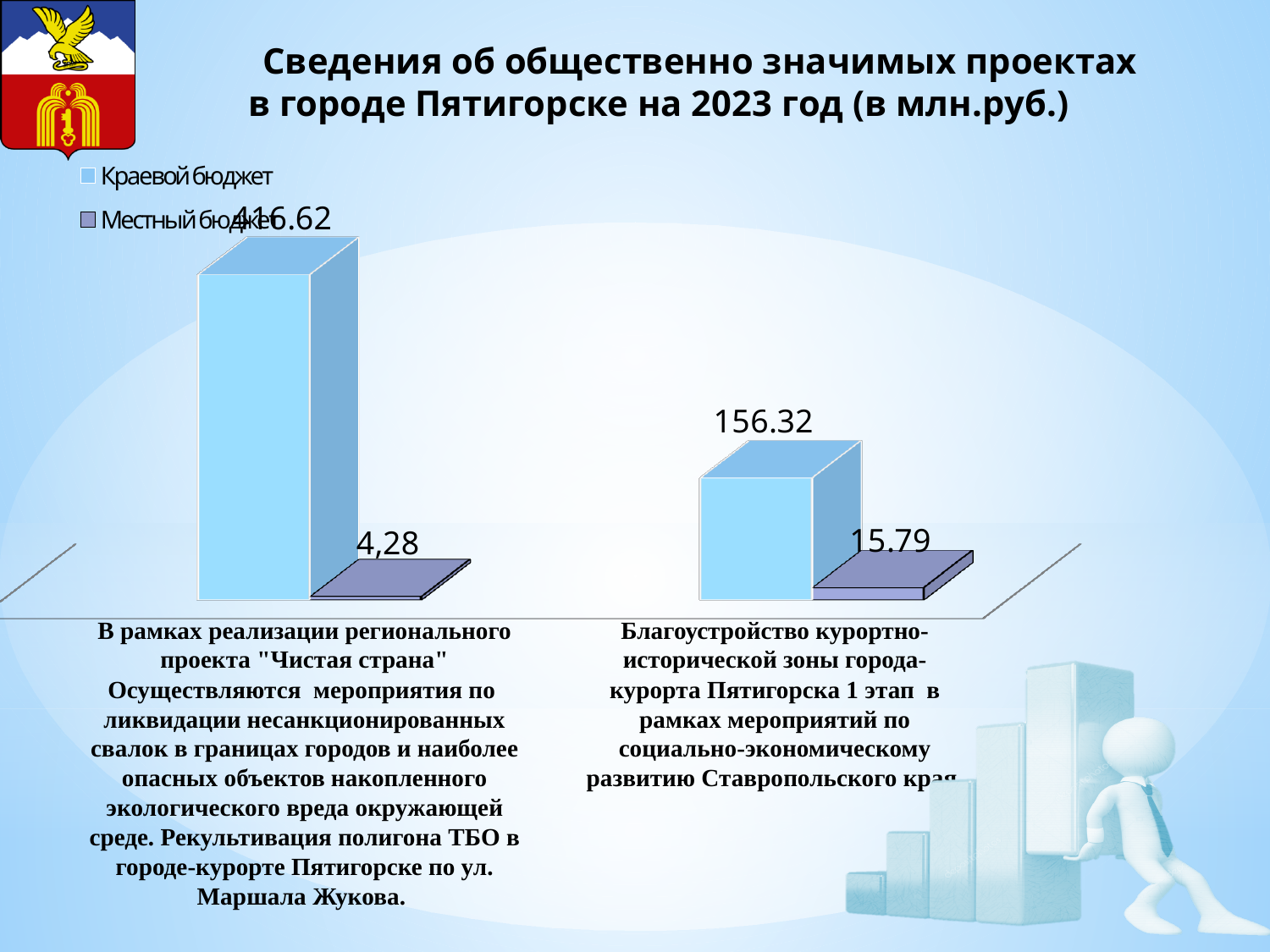
What type of chart is shown on the slide? Bar chart What is the value of Краевой бюджет for the project "Чистая страна"? 416.62 What are the two series named in the legend? Краевой бюджет and Местный бюджет How many project categories are plotted on the chart? 2 What is the difference between the Краевой бюджет values of the two projects (416.62 and 156.32)? 260.30 What is the value of Местный бюджет for the project "Чистая страна"? 4,28 What is the value of Краевой бюджет for the project "Благоустройство курортно-исторической зоны"? 156.32 Which project has the highest Краевой бюджет value? В рамках реализации регионального проекта "Чистая страна" What is the value of Местный бюджет for the project "Благоустройство курортно-исторической зоны"? 15.79 Which project has the lowest Местный бюджет value? В рамках реализации регионального проекта "Чистая страна" How many series does the legend list? 2 Which is larger: Местный бюджет for "Чистая страна" or Местный бюджет for "Благоустройство курортно-исторической зоны"? Благоустройство курортно-исторической зоны (15.79)